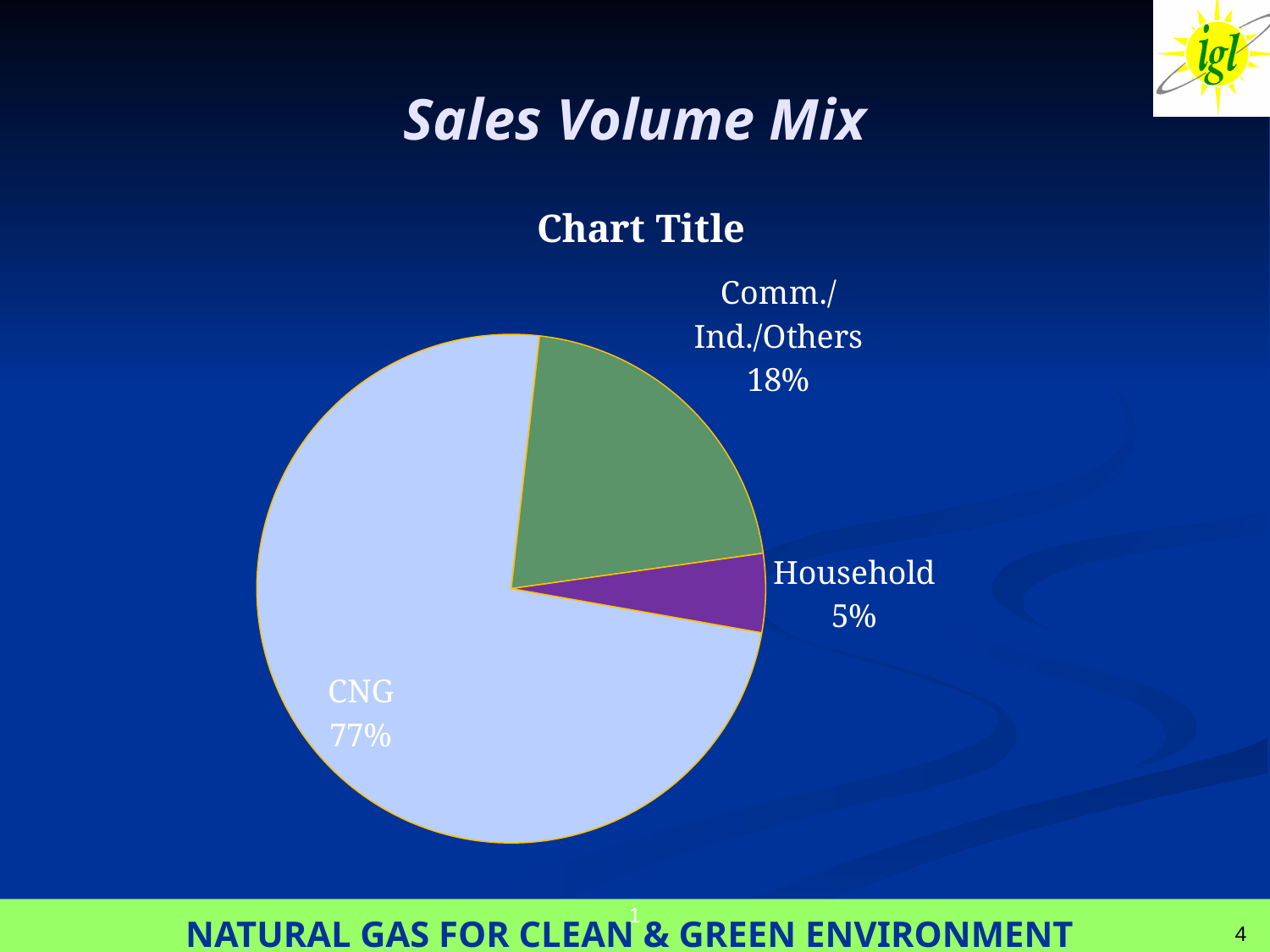
How many slices does the pie chart have? 3 Which is larger, the Household share or the Comm./Ind./Others share? Comm./Ind./Others What is the title shown above the pie chart? Chart Title What is the difference in percentage points between CNG and Comm./Ind./Others? 59 What colour is the Household slice? purple What share of the pie does Household account for? 5% Which category has the largest slice of the pie? CNG What is the difference in percentage points between Comm./Ind./Others and Household? 13 What type of chart is shown on the slide? pie chart What share of the pie does CNG account for? 77% Which category has the smallest slice of the pie? Household What share of the pie does Comm./Ind./Others account for? 18%